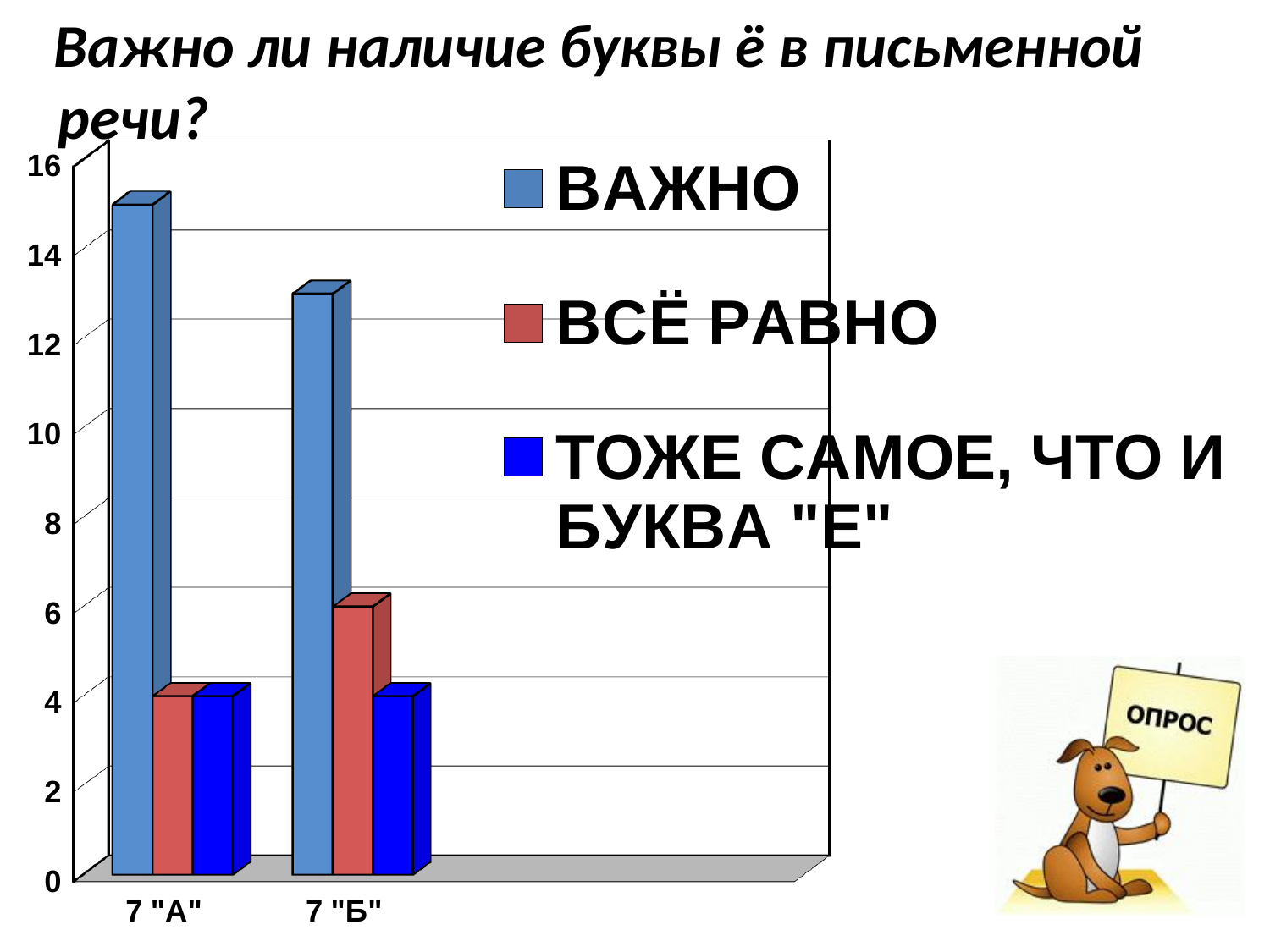
Which series has the highest value for 7 "Б"? ВАЖНО Is the value for ВАЖНО in 7 "А" greater or less than 14? greater Which class has the higher value for ВСЁ РАВНО, 7 "А" or 7 "Б"? 7 "Б" Which series has the lowest value for 7 "Б"? ТОЖЕ САМОЕ, ЧТО И БУКВА "Е" Is the value for ВСЁ РАВНО in 7 "Б" greater or less than 8? less What is the title of the chart on the slide? Важно ли наличие буквы ё в письменной речи? Is the value for ВАЖНО in 7 "Б" greater or less than 12? greater What kind of chart is shown on the slide? Bar chart How many categories (classes) are shown on the x axis of the chart? 2 Which series is shown in red in the chart's legend? ВСЁ РАВНО Which class has the higher value for ВАЖНО, 7 "А" or 7 "Б"? 7 "А" How many series does the chart's legend list? 3